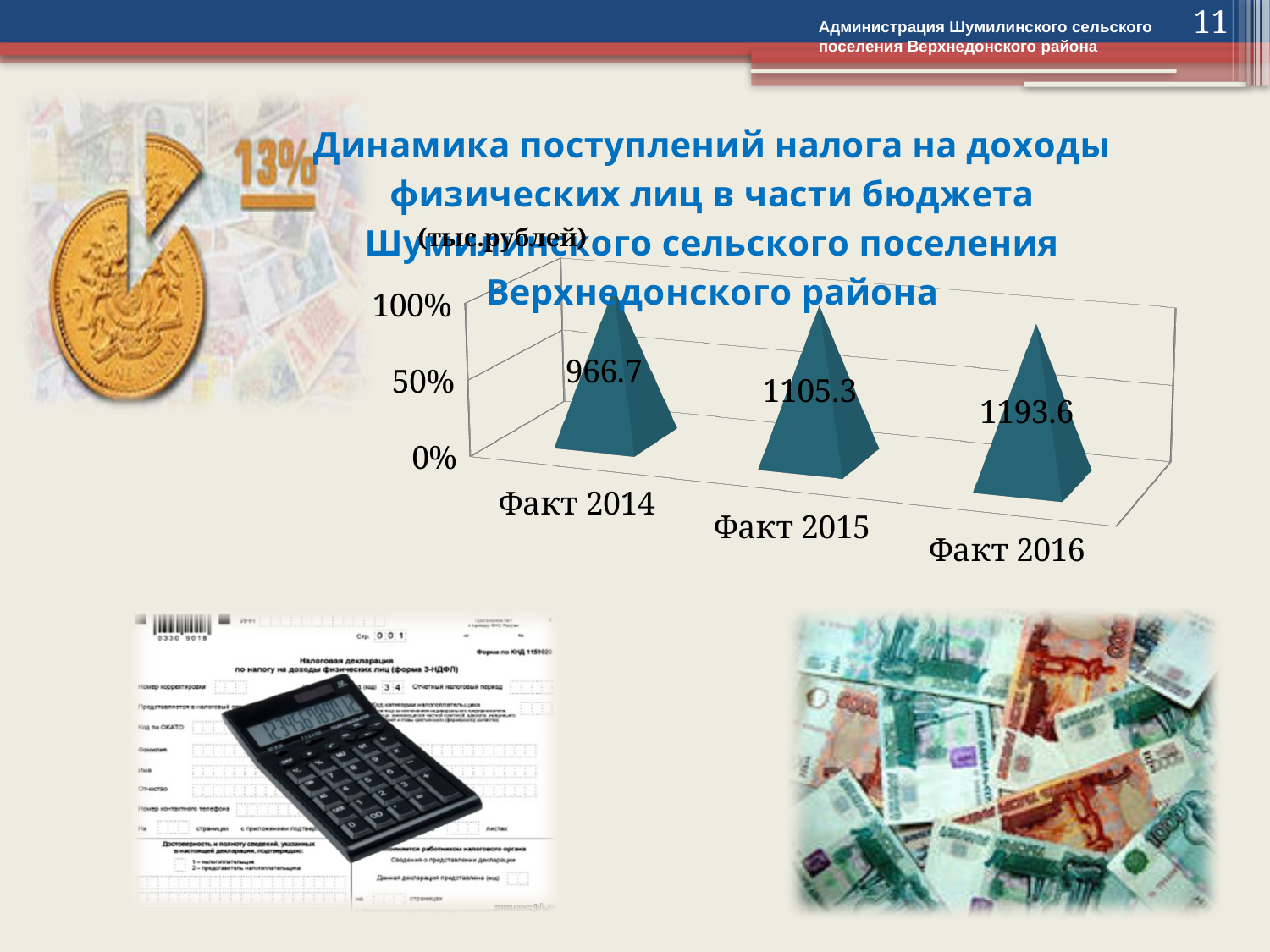
Which category has the highest value? Факт 2016 Which category has the lowest value? Факт 2014 How many categories are shown on the chart? 3 What is the value for Факт 2016? 1193.6 What is the difference between the values for Факт 2015 and Факт 2014? 138.6 What is the value for Факт 2015? 1105.3 What is the difference between the values for Факт 2016 and Факт 2014? 226.9 What kind of chart is shown on the slide? bar chart Do the labelled values rise or fall from Факт 2014 to Факт 2016? rise Which is larger, the value for Факт 2014 or the value for Факт 2016? Факт 2016 What is the difference between the values for Факт 2016 and Факт 2015? 88.3 What is the value for Факт 2014? 966.7